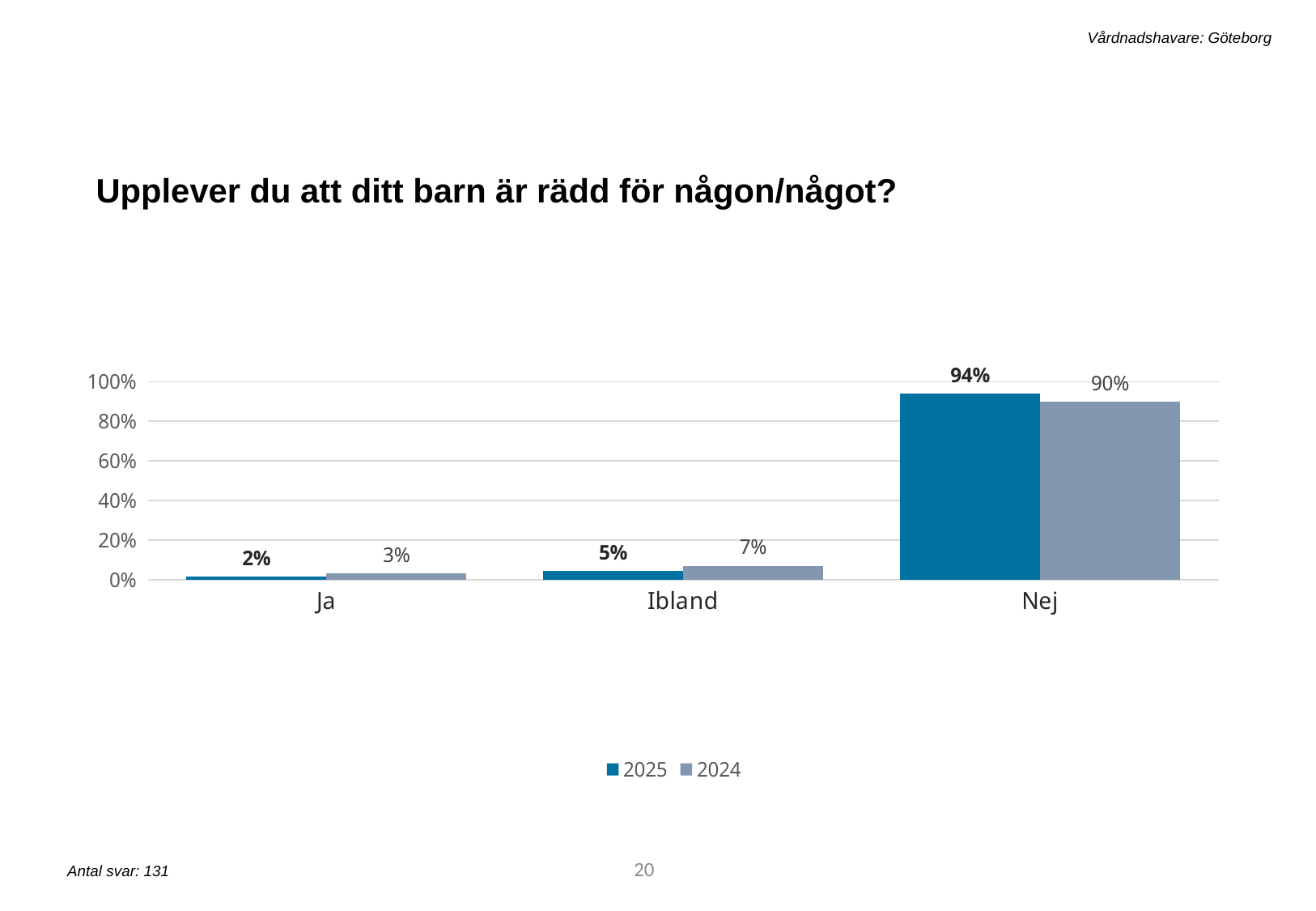
What is the value for Ibland in the 2024 series? 7% What is the title of the chart? Upplever du att ditt barn är rädd för någon/något? What is the difference between the 2025 and 2024 values for Nej? 4 percentage points What kind of chart is shown on the slide? Bar chart What is the value for Nej in the 2024 series? 90% Which is larger for Ibland: the 2025 value or the 2024 value? 2024 Which category has the highest value in the 2025 series? Nej What is the value for Nej in the 2025 series? 94% What is the value for Ja in the 2025 series? 2% How many series does the legend list? 2 Which category has the lowest value in the 2024 series? Ja How many categories are shown on the x axis? 3